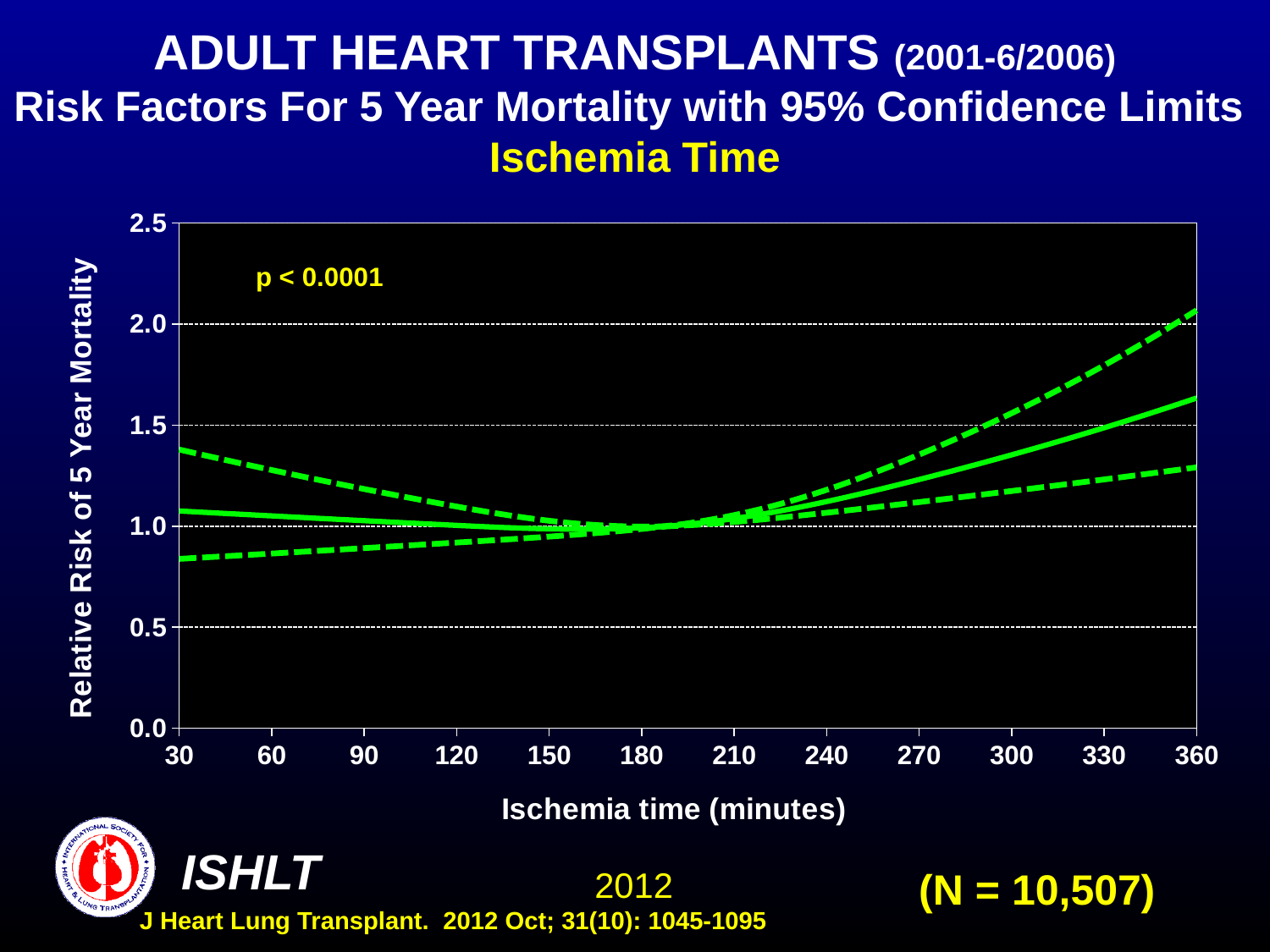
What is the title of the chart's y axis? Relative Risk of 5 Year Mortality What is the sample size (N) shown on the slide? N = 10,507 What p-value is printed on the chart? p < 0.0001 Is the value of the lower dashed confidence limit at an ischemia time of 360 minutes greater or less than 1.5? less Is the value of the upper dashed confidence limit at an ischemia time of 30 minutes greater or less than 1.5? less Does the solid relative risk line rise or fall between ischemia times of 180 and 360 minutes? rise What kind of chart is shown on the slide? line chart Is the value of the solid relative risk line at an ischemia time of 360 minutes greater or less than 1.5? greater What is the title of the chart's x axis? Ischemia time (minutes) How many tick labels are shown on the x axis? 12 How many lines are plotted on the chart? 3